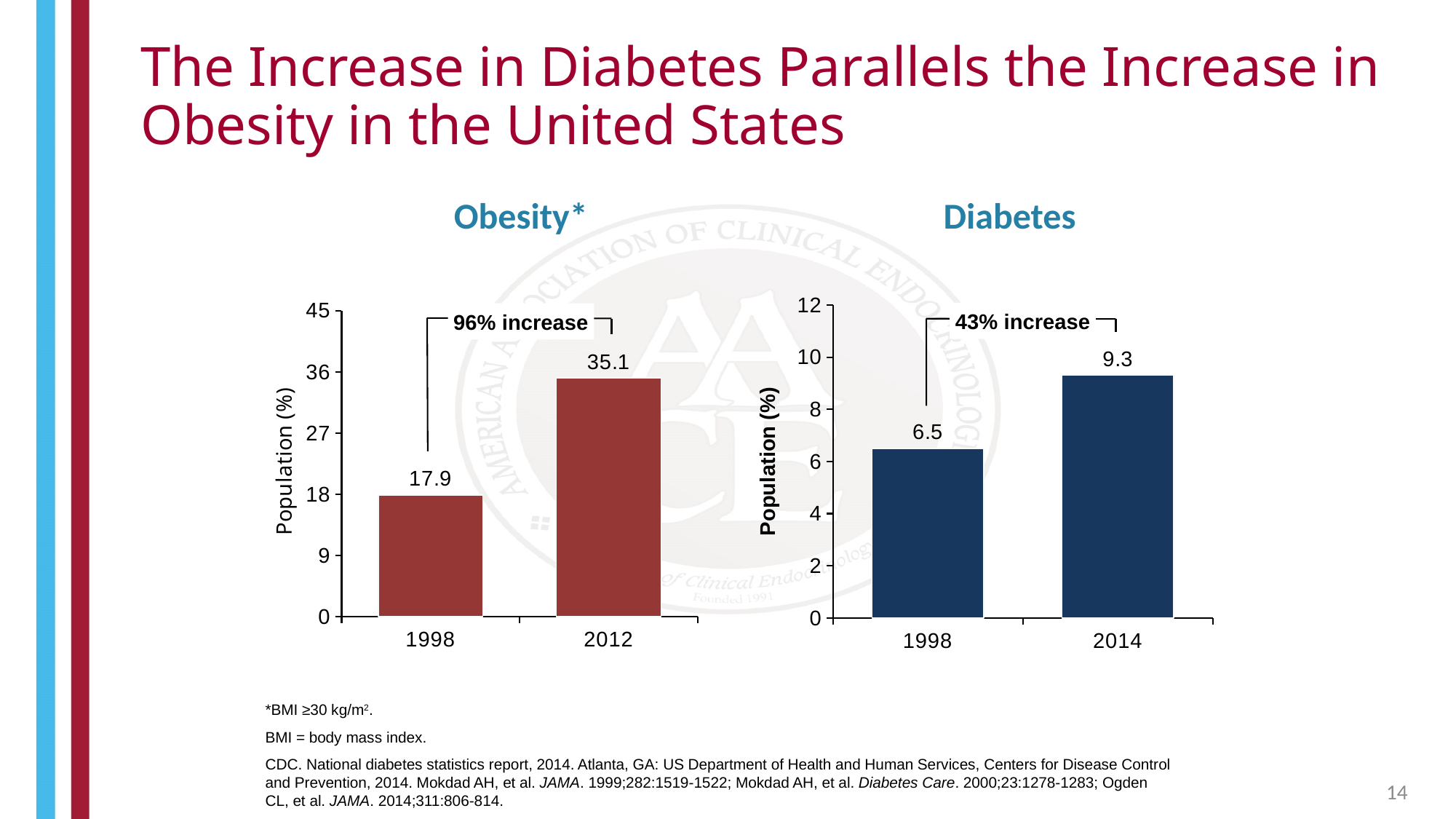
What percentage increase is annotated on the Obesity chart? 96% increase What kind of chart is the Diabetes chart? bar chart How many bars are in the Obesity chart? 2 In the Diabetes chart, what is the value for 1998? 6.5 In the Obesity chart, what is the difference between the 2012 and 1998 values? 17.2 In the Obesity chart, what is the value for 1998? 17.9 In the Diabetes chart, what is the value for 2014? 9.3 In the Diabetes chart, what is the difference between the 2014 and 1998 values? 2.8 In the Obesity chart, what is the value for 2012? 35.1 In the Diabetes chart, is the value for 2014 greater or less than 8? greater In the Obesity chart, which year has the higher value? 2012 In the Diabetes chart, which year has the lower value? 1998